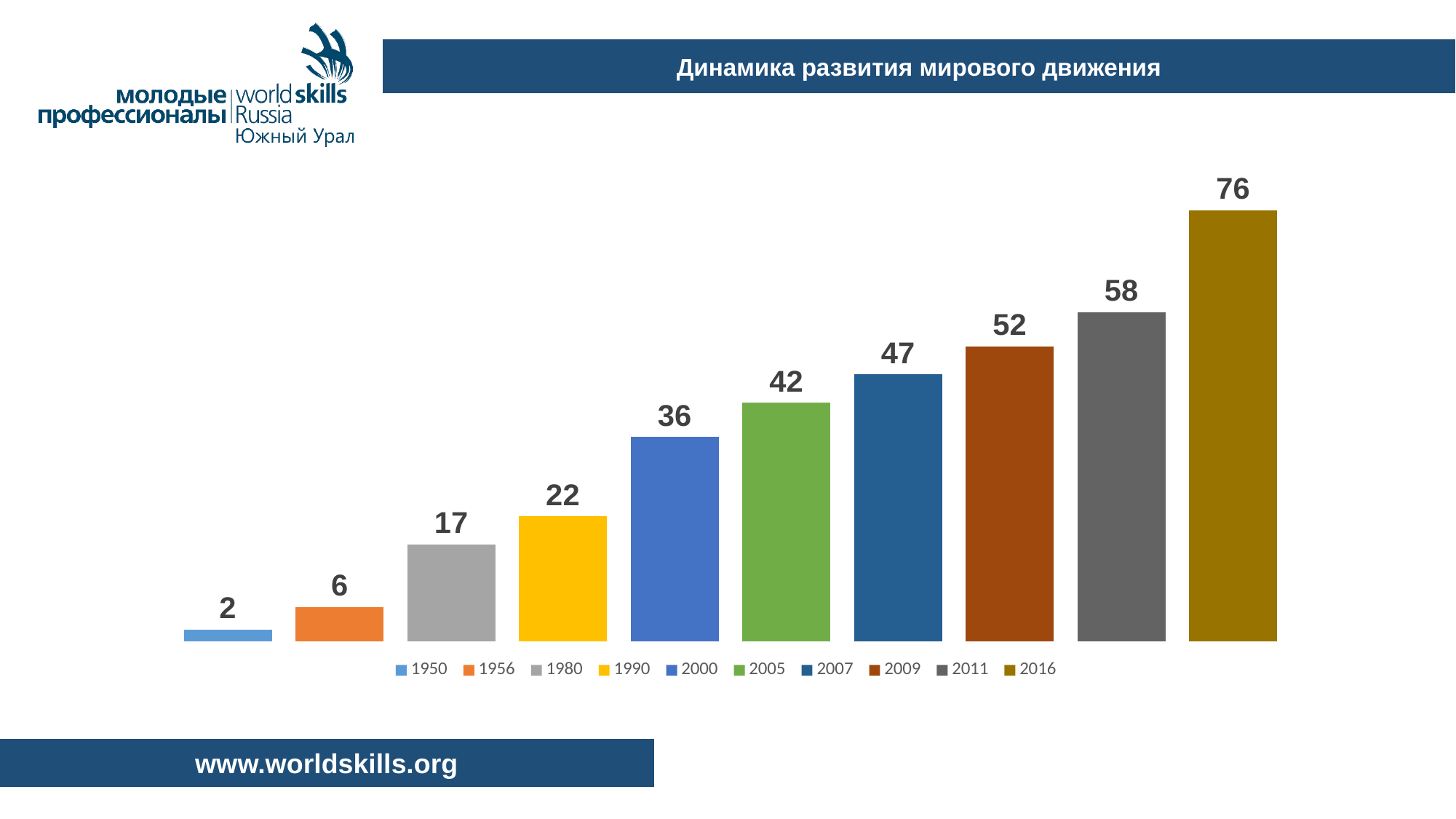
What is the value for 2016? 76 What is the value for 2005? 42 Do the values rise or fall from 1950 to 2016? rise Which is larger, the value for 2007 or the value for 2009? 2009 What kind of chart is shown on the slide? bar chart What is the difference between the values for 2000 and 1980? 19 What is the difference between the values for 2016 and 2011? 18 How many bars are shown in the chart? 10 How many entries does the legend list? 10 What is the value for 1990? 22 Which year has the highest value? 2016 Which year has the lowest value? 1950